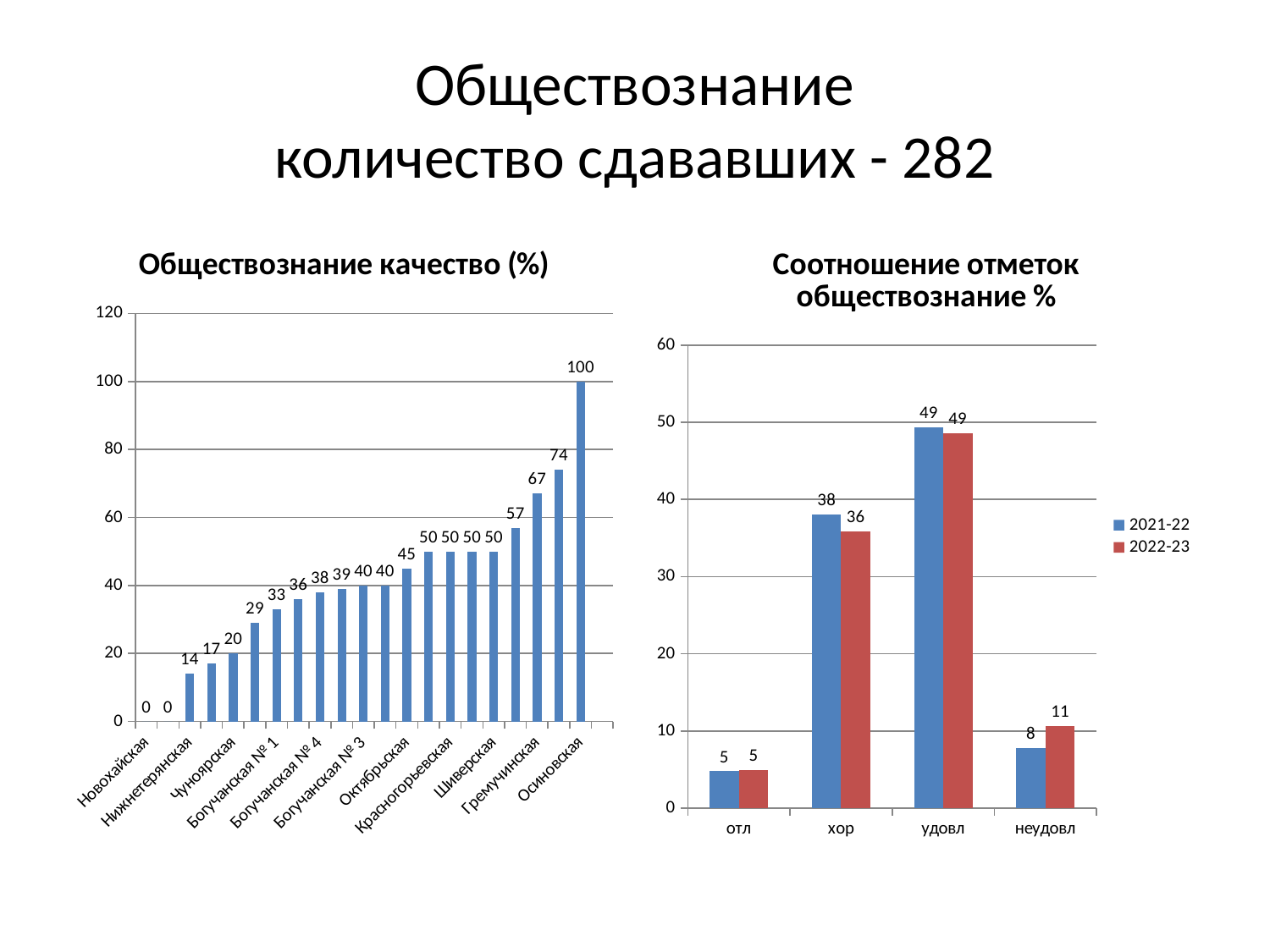
In the left chart "Обществознание качество (%)", which category has the highest value? Осиновская In the right chart "Соотношение отметок обществознание %", what is the value for неудовл in 2021-22? 8 In the right chart "Соотношение отметок обществознание %", which category has the highest value for 2021-22? удовл In the left chart "Обществознание качество (%)", what is the value for Осиновская? 100 In the right chart "Соотношение отметок обществознание %", what is the difference between the 2021-22 and 2022-23 values for хор? 2 In the left chart "Обществознание качество (%)", is the value for Чуноярская greater or less than 40? less In the right chart "Соотношение отметок обществознание %", how many categories are shown on the x axis? 4 In the right chart "Соотношение отметок обществознание %", what is the value for хор in 2022-23? 36 In the right chart "Соотношение отметок обществознание %", how many series does the legend list? 2 In the right chart "Соотношение отметок обществознание %", which year has the larger value for неудовл? 2022-23 What kind of chart is the left chart titled "Обществознание качество (%)"? bar chart What are the two legend entries in the right chart "Соотношение отметок обществознание %"? 2021-22 and 2022-23